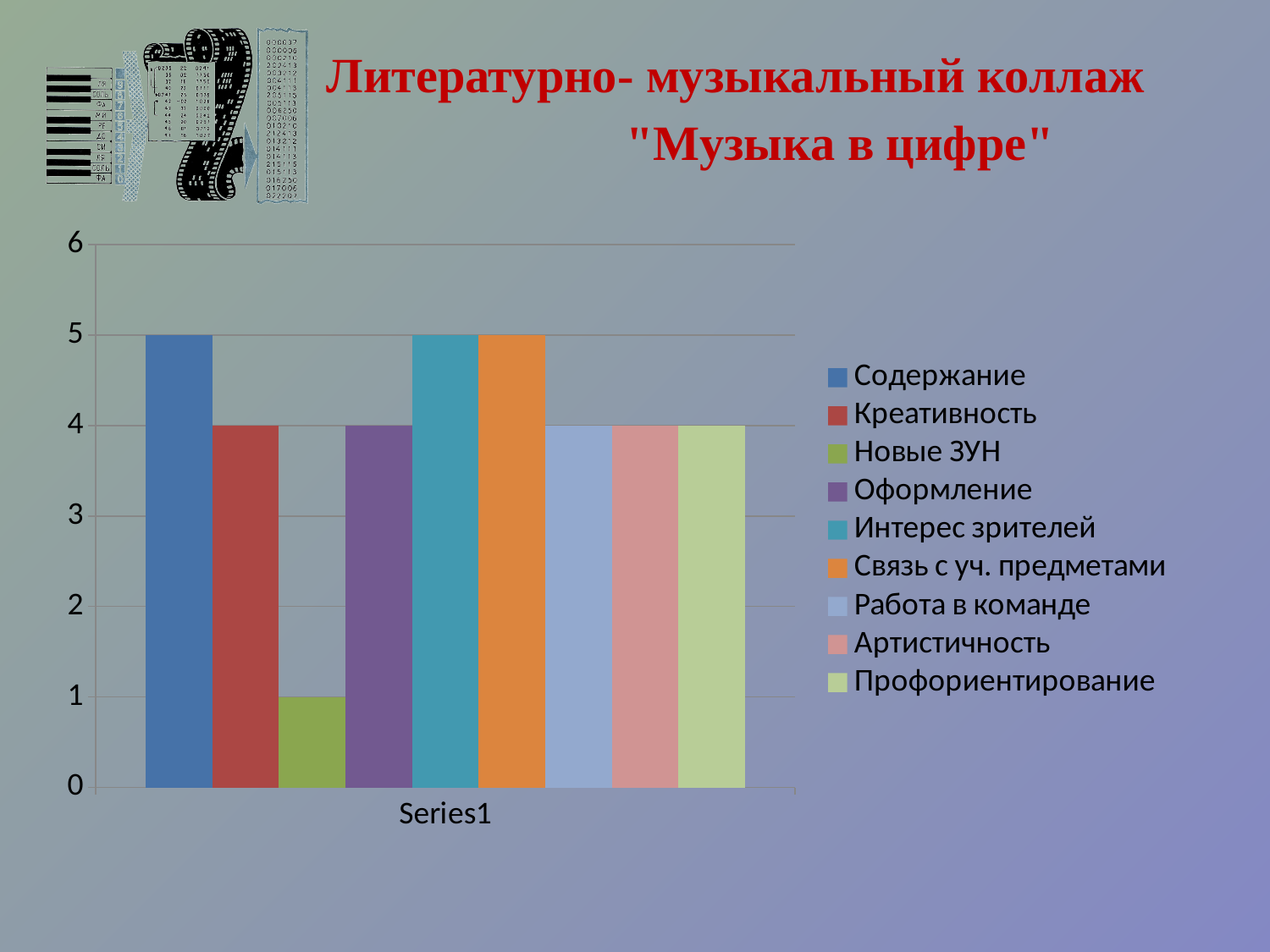
What is the highest value shown on the vertical axis? 6 What is the difference between the values for Содержание and Новые ЗУН? 4 Which series has the lowest value? Новые ЗУН What kind of chart is shown on the slide? bar chart What is the value for Креативность? 4 Is the value for Артистичность greater or less than 3? greater How many series does the legend list? 9 What is the value for Содержание? 5 What is the category label shown on the x axis? Series1 Which is larger, the value for Связь с уч. предметами or the value for Работа в команде? Связь с уч. предметами What is the value for Новые ЗУН? 1 What is the value for Интерес зрителей? 5